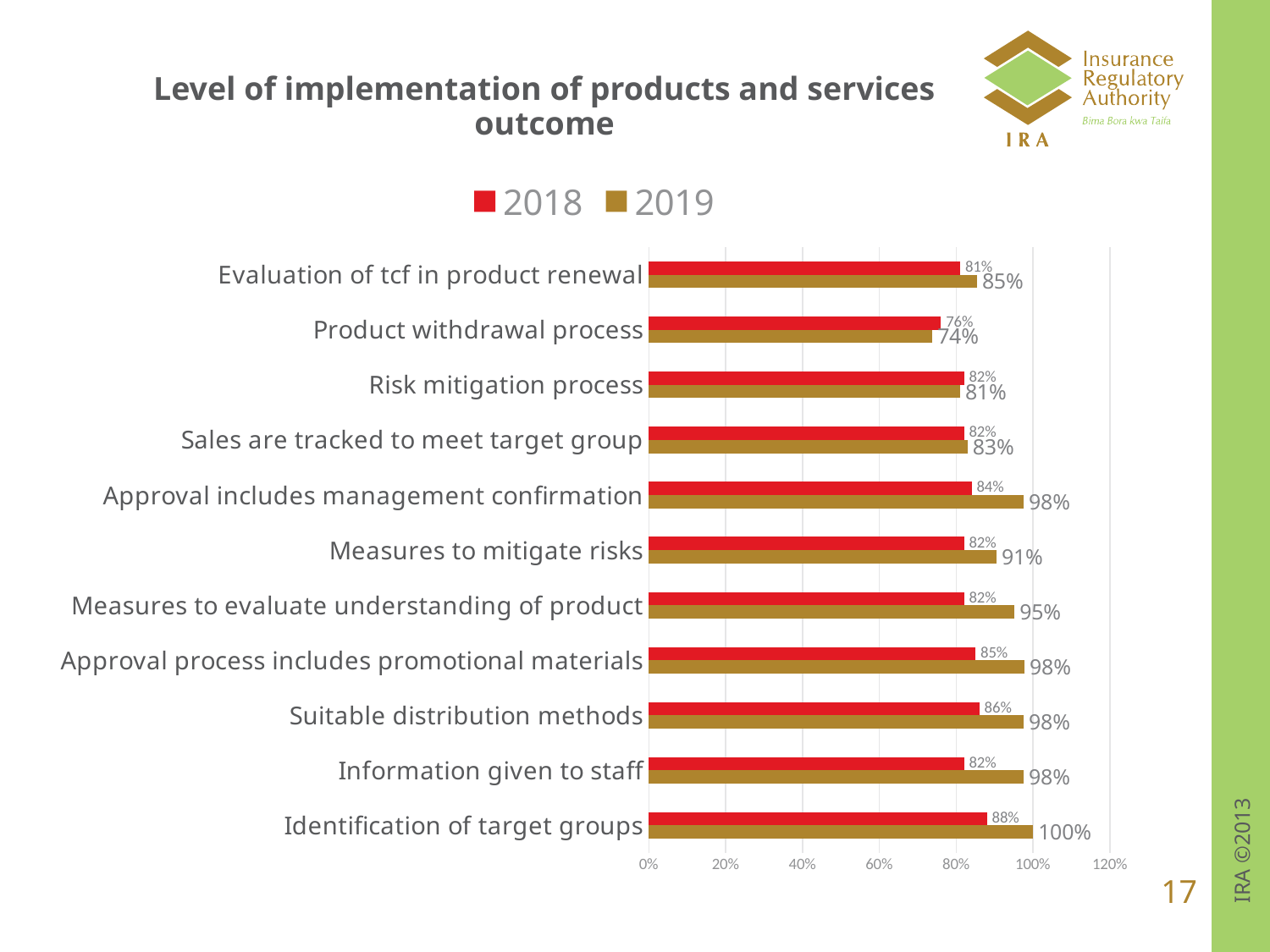
Which category has the highest 2018 value? Identification of target groups What is the title of the chart? Level of implementation of products and services outcome Which category has the lowest 2019 value? Product withdrawal process What is the 2018 value for Product withdrawal process? 76% What is the 2018 value for Suitable distribution methods? 86% For Product withdrawal process, which year has the larger value, 2018 or 2019? 2018 What is the 2019 value for Measures to mitigate risks? 91% How many series does the legend list? 2 What is the 2019 value for Identification of target groups? 100% How many categories are shown on the chart? 11 What kind of chart is shown on the slide? Bar chart What is the difference between the 2019 and 2018 values for Approval includes management confirmation? 14%